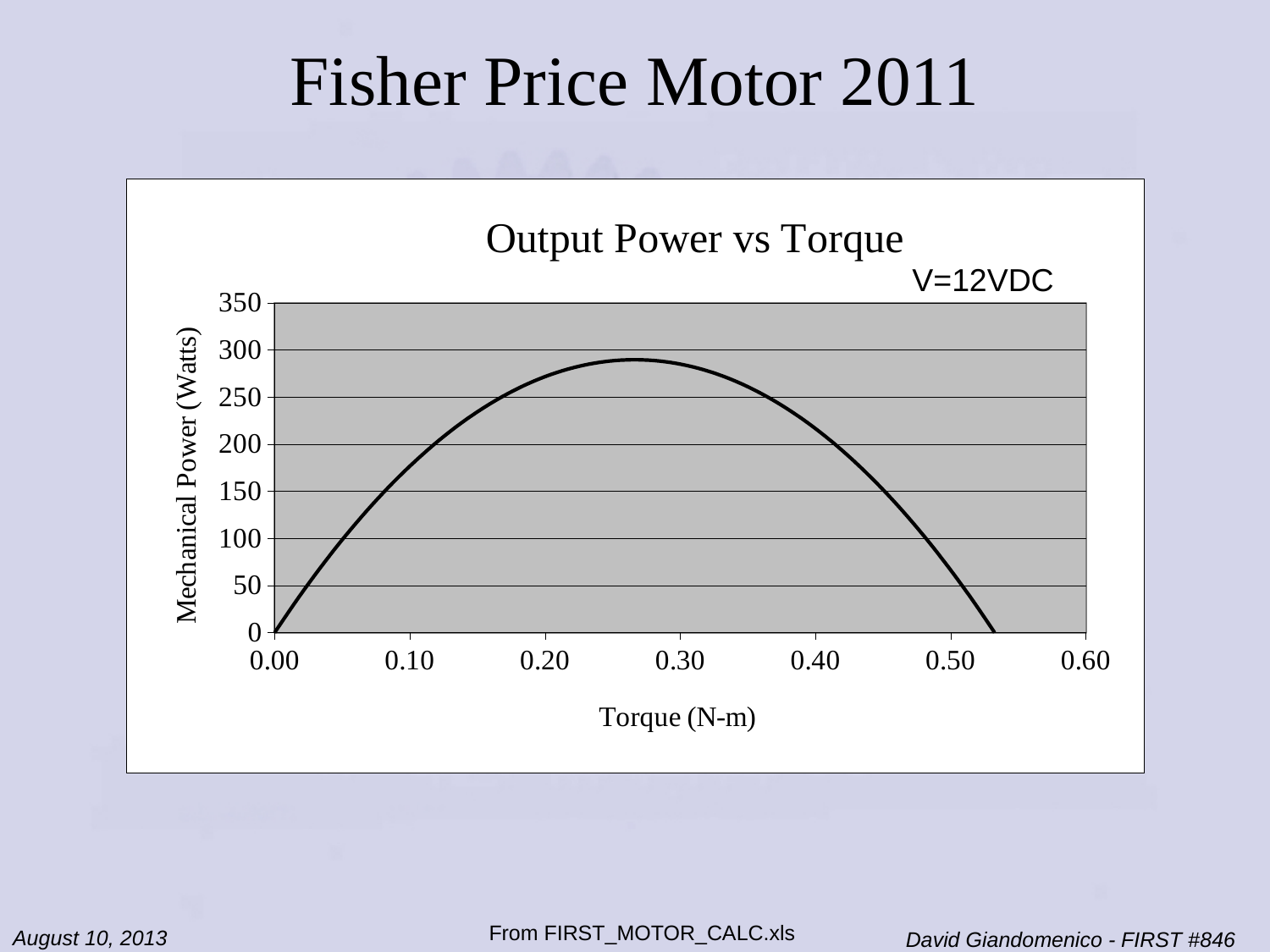
What kind of chart is shown on the slide? line chart Is the peak mechanical power on the curve greater or less than 300? less Is the mechanical power at a torque of 0.50 N-m greater or less than 100? less How does mechanical power change as torque increases from 0.00 to 0.50 N-m? rises then falls Is the peak mechanical power on the curve greater or less than 250? greater What is the mechanical power at a torque of 0.00 N-m? 0 What is the title of the chart? Output Power vs Torque Does mechanical power rise or fall as torque increases from 0.30 to 0.50 N-m? falls What is the label of the y axis? Mechanical Power (Watts)